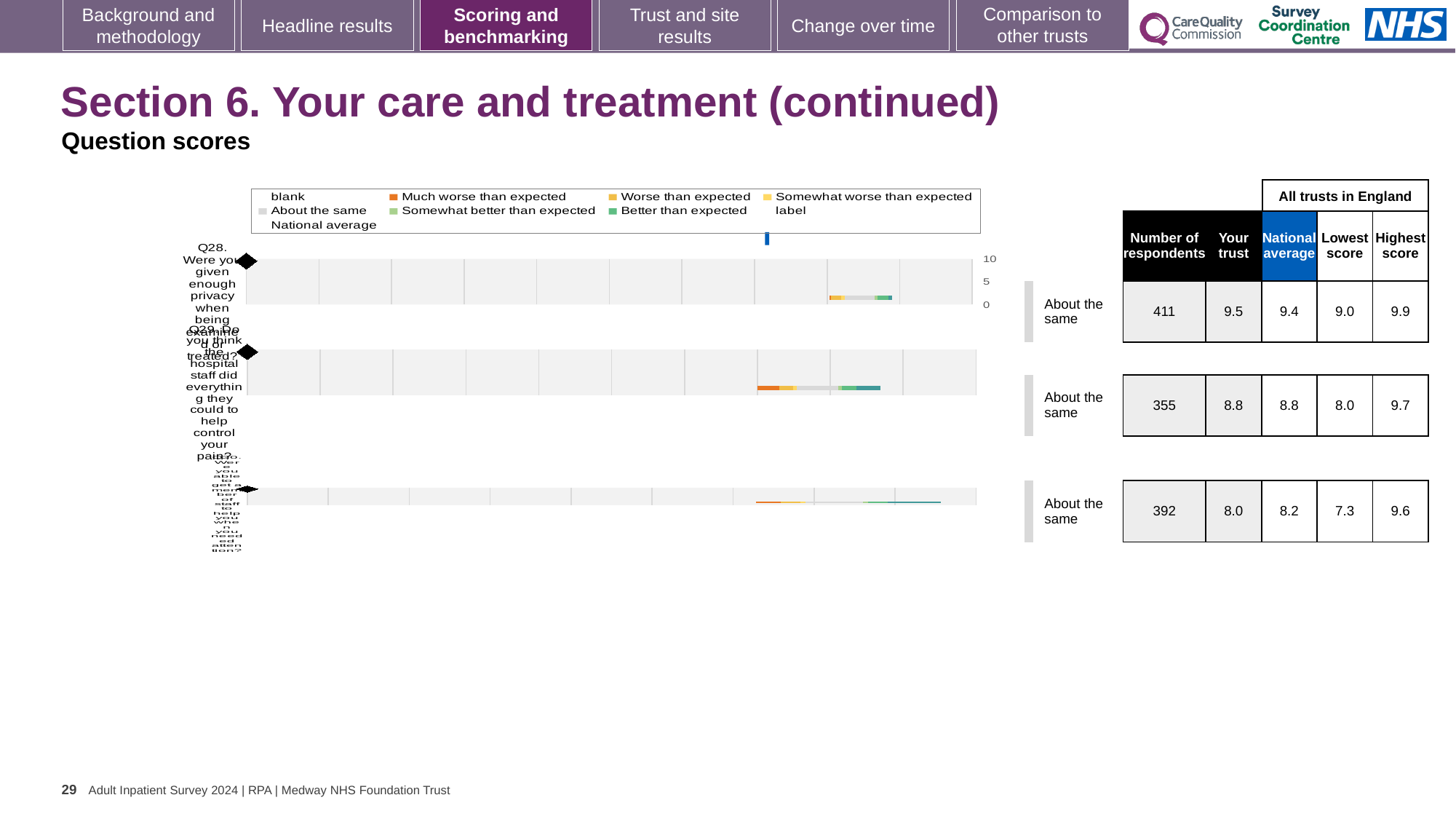
For Q29, what is the difference between the highest score and the lowest score across all trusts in England? 1.7 For Q30, what is the lowest score among all trusts in England? 7.3 For Q29 (staff did everything to help control your pain), what is the national average score? 8.8 What benchmark category is shown for Q29? About the same Which question has the lowest 'Your trust' score on this slide? Q30 For Q28 (privacy when being examined or treated), what is the 'Your trust' score? 9.5 What kind of chart is used to show the question scores on this slide? bar chart How many respondents answered Q30? 392 How many questions (Q28, Q29, Q30) are plotted on this slide? 3 For Q28, what is the difference between the highest score and the lowest score across all trusts in England? 0.9 For Q30, which is larger: the 'Your trust' score or the national average? National average Which question has the highest 'Your trust' score on this slide? Q28